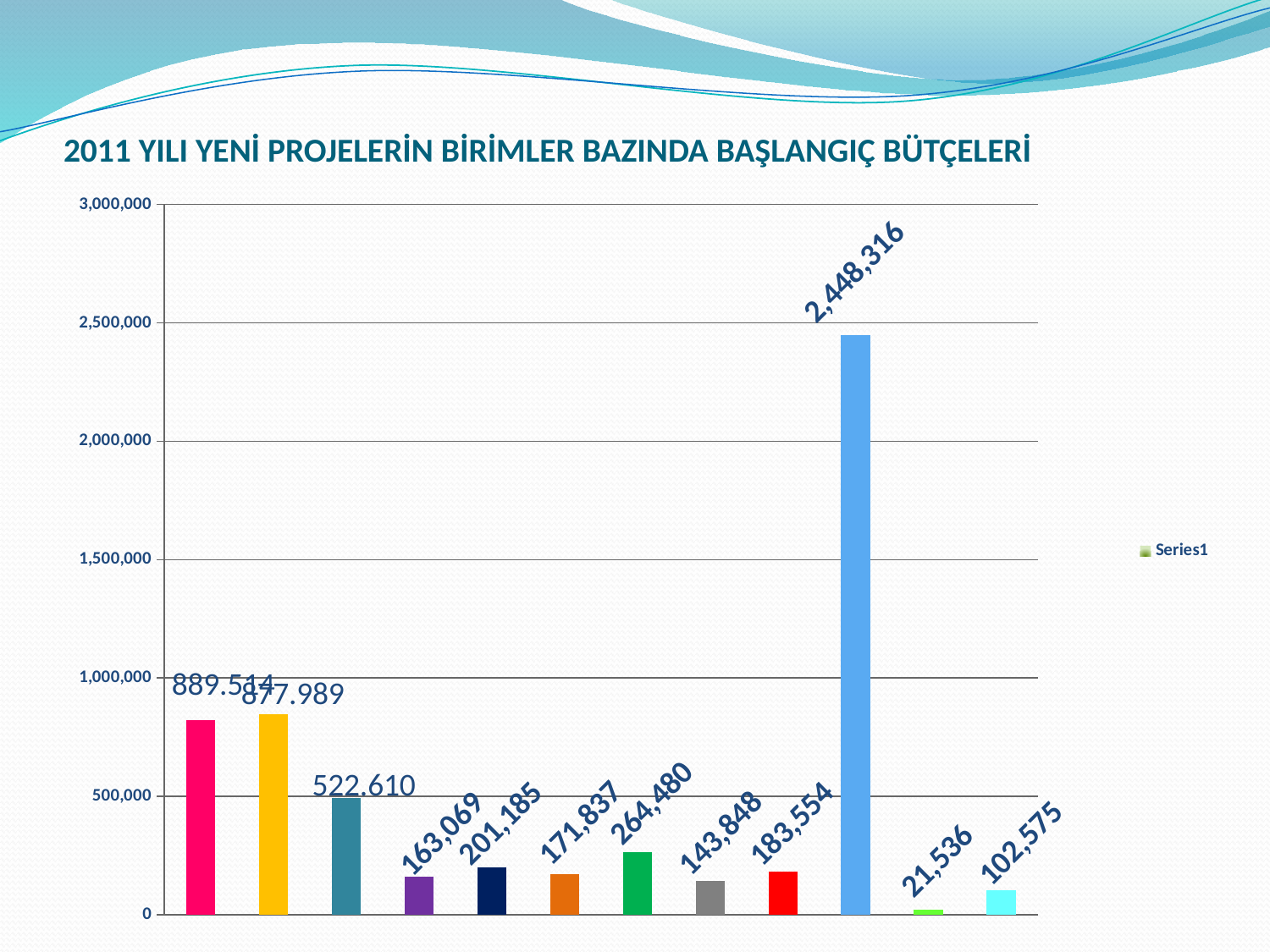
What is the only entry shown in the chart legend? Series1 What is the value of the shortest bar in the chart? 21,536 How many series does the legend list? 1 What is the value of the tallest bar in the chart? 2,448,316 What kind of chart is shown on the slide? bar chart Which is larger: the purple bar (fourth from the left) or the dark navy bar (fifth from the left)? the dark navy bar (201,185) Is the value of the tallest bar greater or less than 2,000,000? greater What is the difference between the green bar (264,480) and the red bar (183,554)? 80,926 What is the value shown on the red bar (ninth from the left)? 183,554 What is the value shown on the last (rightmost, light cyan) bar? 102,575 What is the value shown on the green bar (seventh from the left)? 264,480 How many bars are plotted in the chart? 12